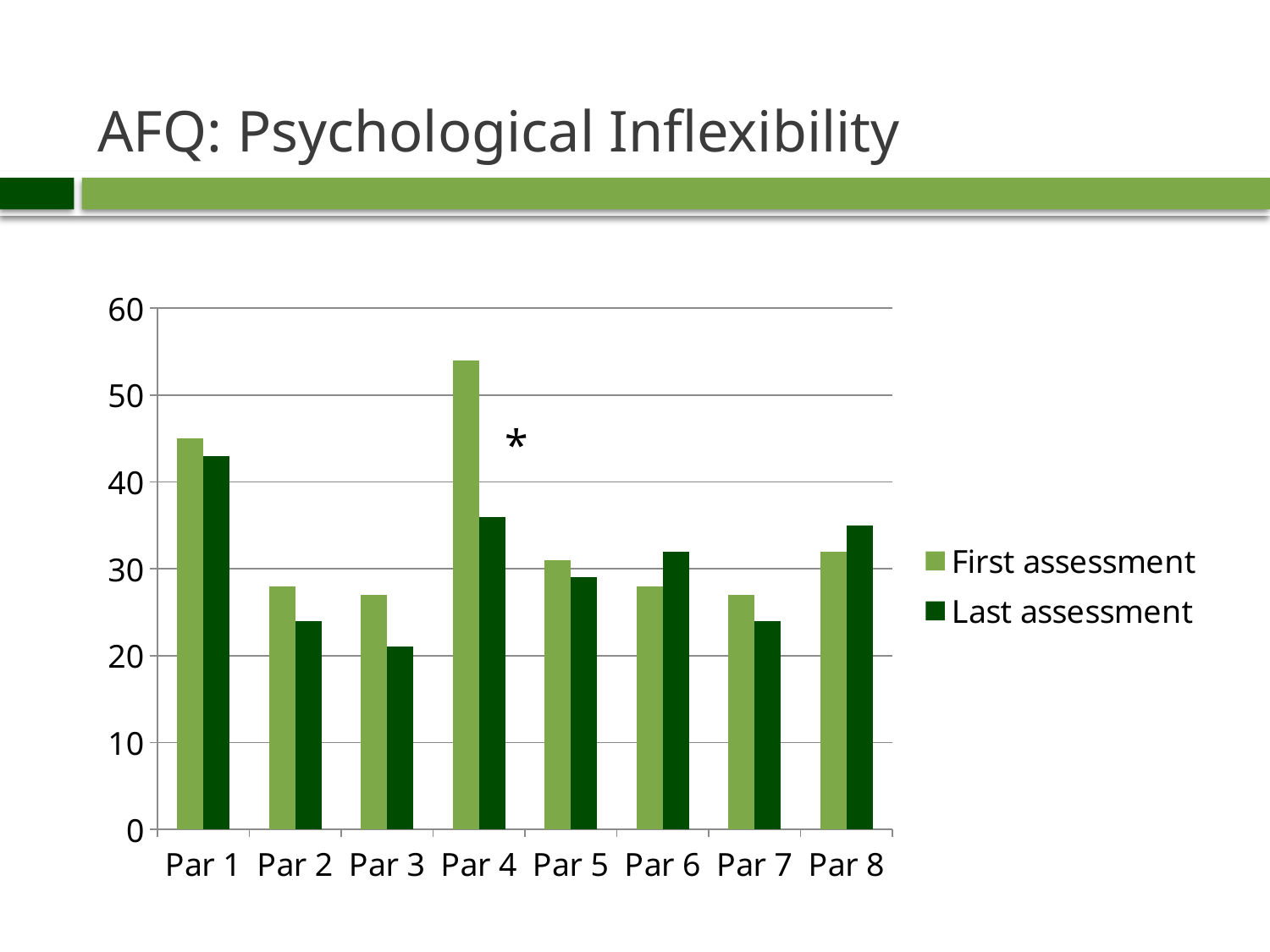
For Par 6, which is larger: the First assessment or the Last assessment value? Last assessment Which participant has the highest First assessment value? Par 4 For Par 4, which is larger: the First assessment or the Last assessment value? First assessment What is the title of the slide containing the chart? AFQ: Psychological Inflexibility Is the First assessment value for Par 1 greater or less than 40? greater Which participant's bars are marked with an asterisk? Par 4 Which participant has the lowest Last assessment value? Par 3 How many participants (categories) are shown on the x axis? 8 What kind of chart is shown on the slide? bar chart Is the First assessment value for Par 4 greater or less than 50? greater Is the Last assessment value for Par 3 greater or less than 30? less How many series does the legend list? 2